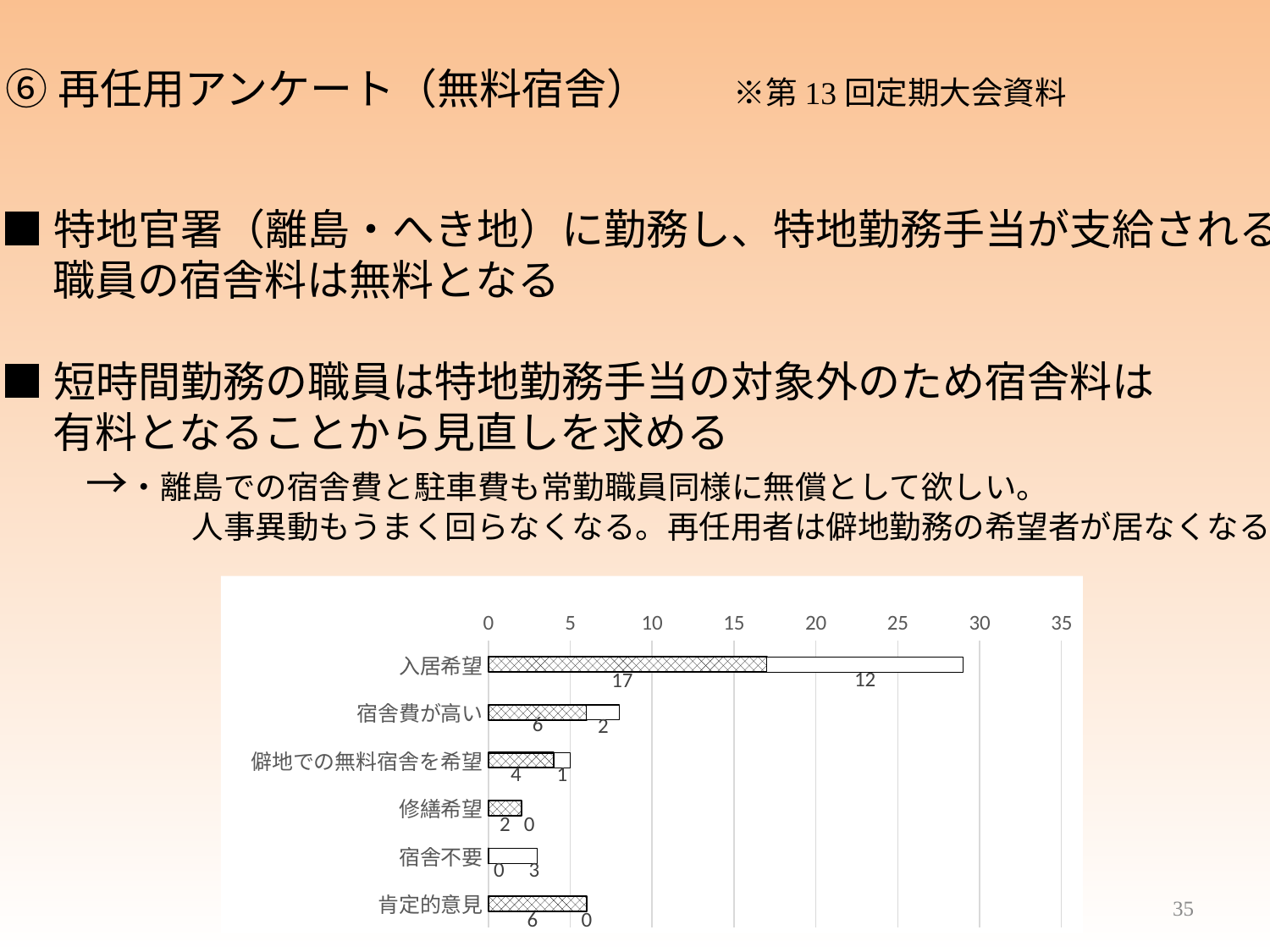
What kind of chart is shown on the slide? Stacked horizontal bar chart Which category has the shortest stacked bar overall? 修繕希望 Which has a larger white segment value, 宿舎不要 or 宿舎費が高い? 宿舎不要 What is the value of the hatched segment for 入居希望? 17 What is the total of the stacked bar for 宿舎費が高い? 8 Which category has the longest stacked bar overall? 入居希望 How many categories are shown on the chart? 6 What is the difference between the hatched segment values for 入居希望 and 宿舎費が高い? 11 What is the value of the white segment for 入居希望? 12 What is the total length of the stacked bar for 入居希望? 29 Is the total bar length for 入居希望 greater or less than 25? greater What is the highest tick value shown on the horizontal axis? 35